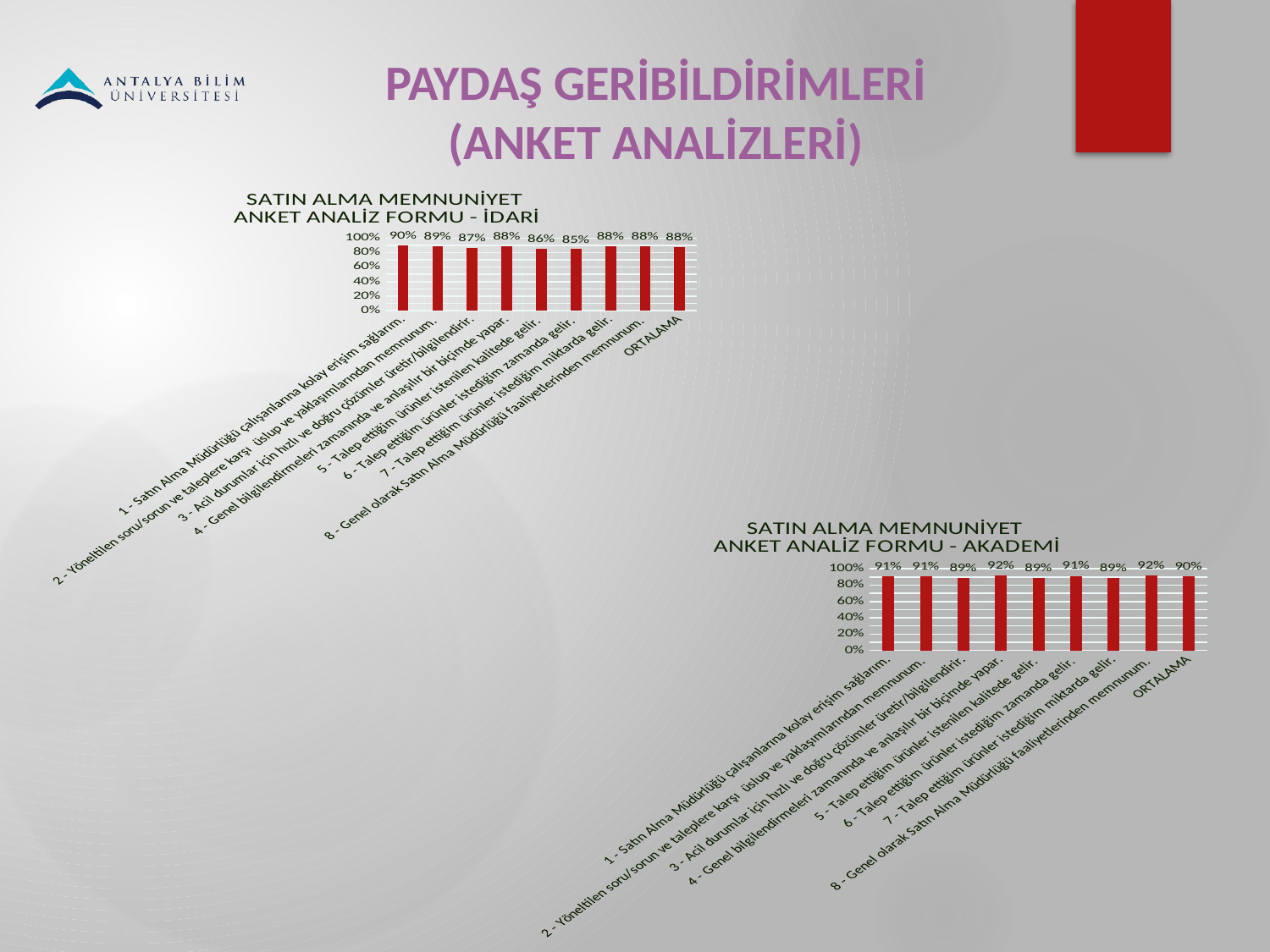
In the 'SATIN ALMA MEMNUNİYET ANKET ANALİZ FORMU - AKADEMİ' chart, is the value for '5 - Talep ettiğim ürünler istenilen kalitede gelir.' greater or less than 80%? greater In the 'SATIN ALMA MEMNUNİYET ANKET ANALİZ FORMU - AKADEMİ' chart, what is the value for ORTALAMA? 90% In the 'SATIN ALMA MEMNUNİYET ANKET ANALİZ FORMU - İDARİ' chart, which category has the highest value? 1 - Satın Alma Müdürlüğü çalışanlarına kolay erişim sağlarım. In the 'SATIN ALMA MEMNUNİYET ANKET ANALİZ FORMU - AKADEMİ' chart, what is the value for '4 - Genel bilgilendirmeleri zamanında ve anlaşılır bir biçimde yapar.'? 92% In the 'SATIN ALMA MEMNUNİYET ANKET ANALİZ FORMU - İDARİ' chart, what is the difference between the value for category 1 and the value for category 6? 5% In the 'SATIN ALMA MEMNUNİYET ANKET ANALİZ FORMU - İDARİ' chart, which category has the lowest value? 6 - Talep ettiğim ürünler istediğim zamanda gelir. In the 'SATIN ALMA MEMNUNİYET ANKET ANALİZ FORMU - İDARİ' chart, what is the value for '3 - Acil durumlar için hızlı ve doğru çözümler üretir/bilgilendirir.'? 87% Which is larger: the ORTALAMA value in the İDARİ chart or the ORTALAMA value in the AKADEMİ chart? AKADEMİ How many bars are plotted in the 'SATIN ALMA MEMNUNİYET ANKET ANALİZ FORMU - AKADEMİ' chart? 9 What type of chart is the 'SATIN ALMA MEMNUNİYET ANKET ANALİZ FORMU - İDARİ' chart? Bar chart What colour are the bars in the two charts on the slide? Red In the 'SATIN ALMA MEMNUNİYET ANKET ANALİZ FORMU - İDARİ' chart, what is the value for ORTALAMA? 88%